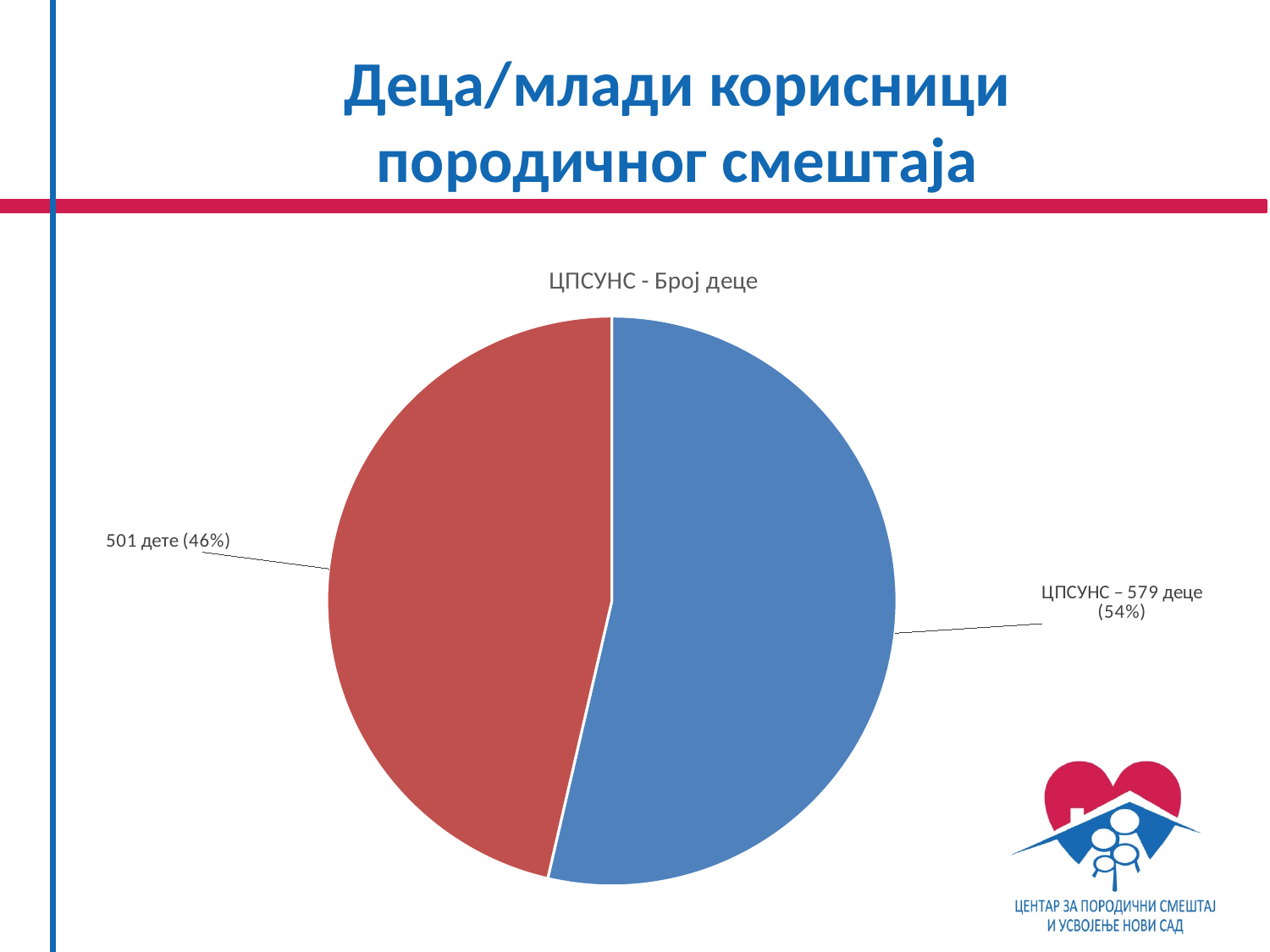
What is the total number of children across both slices of the pie? 1080 What is the title of the chart? ЦПСУНС - Број деце What share of the pie does the red slice (501 дете) represent? 46% How many slices does the pie chart have? 2 What value is printed on the red slice's label? 501 дете Which slice is the smallest in the pie chart? 501 дете (46%) What share of the pie does the ЦПСУНС slice represent? 54% What number of children is shown for the ЦПСУНС slice? 579 деце What colour is the ЦПСУНС – 579 деце slice? blue Which slice is the largest in the pie chart? ЦПСУНС – 579 деце (54%) What kind of chart is shown on the slide? pie chart What is the difference between the 579 деце slice and the 501 дете slice? 78